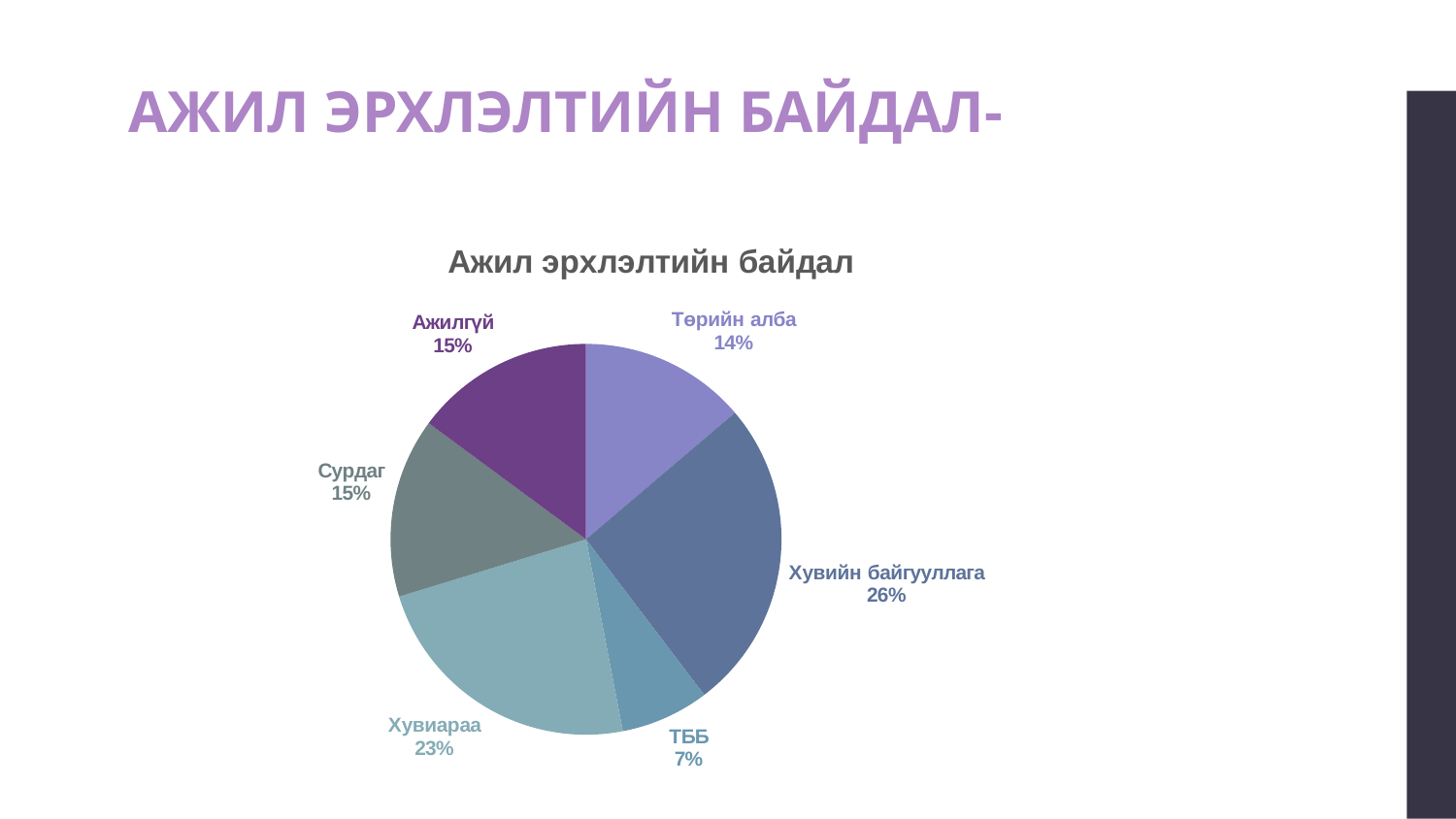
What is the combined share of Ажилгүй and Сурдаг? 30% What share of the pie does ТББ have? 7% What type of chart is shown on the slide? pie chart Which category has the smallest slice of the pie? ТББ What share of the pie does Хувиараа have? 23% How many slices does the pie chart have? 6 What share of the pie does Төрийн алба have? 14% What is the title of the chart? Ажил эрхлэлтийн байдал Which is larger, the share for Сурдаг or the share for ТББ? Сурдаг Which category has the largest slice of the pie? Хувийн байгууллага What is the difference between the shares of Хувийн байгууллага and Хувиараа? 3% What share of the pie does Хувийн байгууллага have? 26%